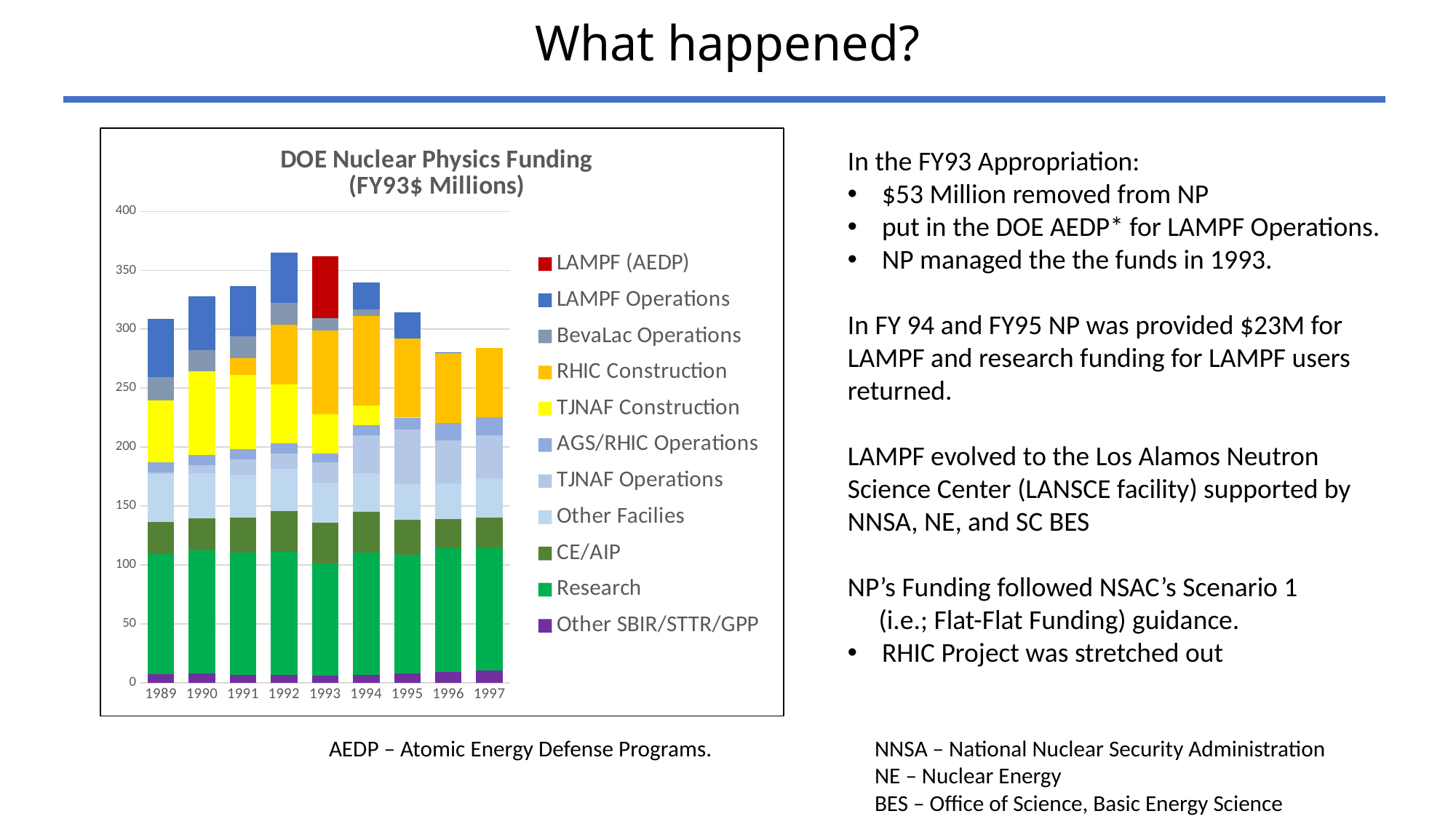
Which year has the larger total funding, 1990 or 1996? 1990 Is the total funding for 1989 greater or less than 300? greater In which year does the LAMPF (AEDP) series appear in the chart? 1993 Do the total funding bars rise or fall from 1993 to 1996? fall Is the total funding for 1996 greater or less than 300? less What kind of chart is shown on the slide? bar chart How many years are shown on the x axis of the chart? 9 How many series does the chart's legend list? 11 Is the total funding for 1992 greater or less than 350? greater What is the title of the chart? DOE Nuclear Physics Funding (FY93$ Millions) Which year has the larger total funding, 1992 or 1997? 1992